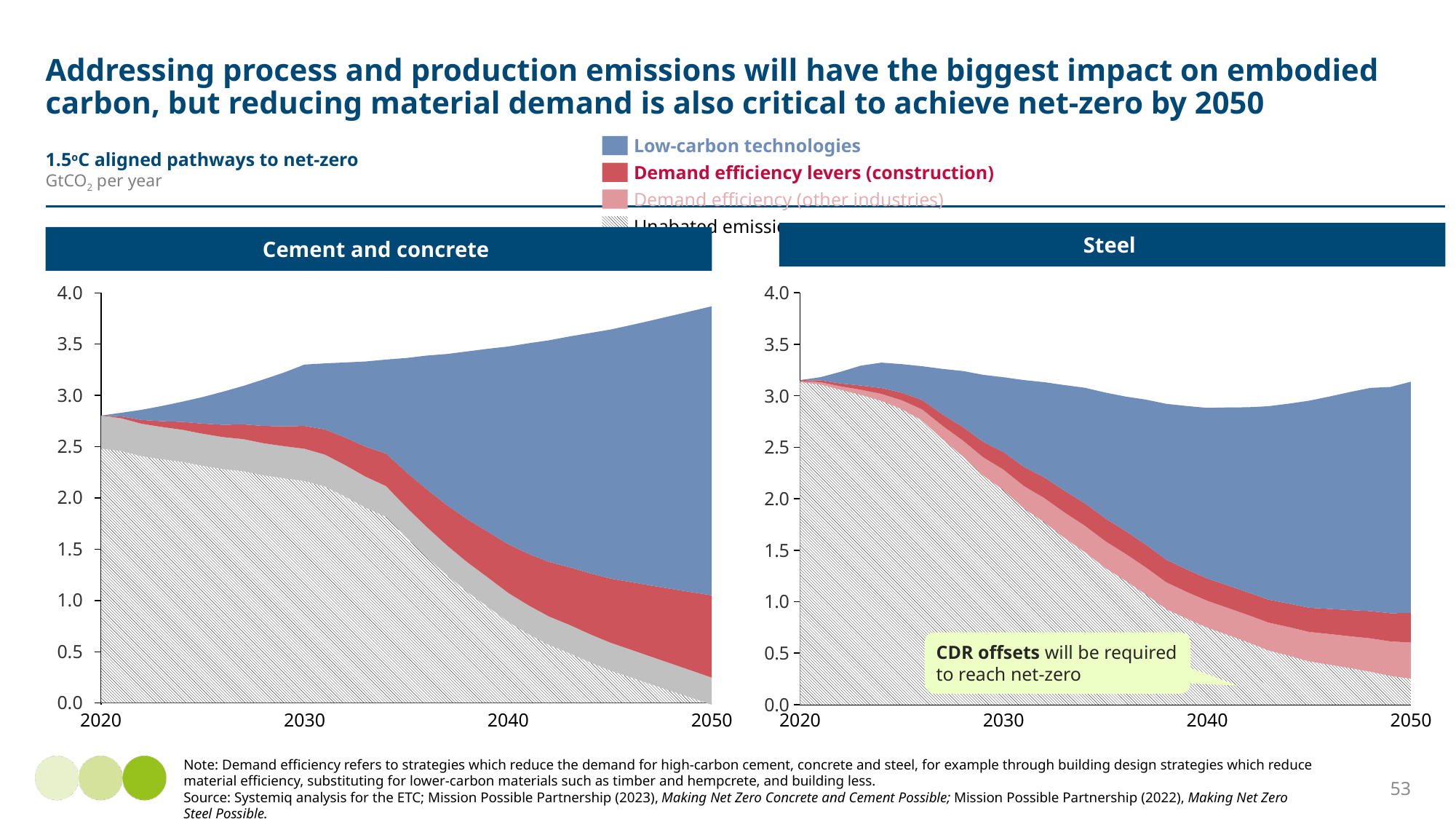
What unit is shown for the y axis of the charts? GtCO2 per year In the Steel chart, is the unabated emissions value in 2050 greater or less than 0.5? less In the Steel chart, is the unabated emissions value in 2040 greater or less than 1.0? less In the Cement and concrete chart, is the unabated emissions value in 2020 greater or less than 2.0? greater How many series does the legend list? 4 In the Cement and concrete chart, does the top of the stacked area rise or fall from 2020 to 2050? rise What kind of chart is the Cement and concrete chart? Stacked area chart In 2050, which chart shows the larger total stacked value, Cement and concrete or Steel? Cement and concrete What does the callout on the Steel chart say will be required to reach net-zero? CDR offsets In the Cement and concrete chart, does the unabated emissions area rise or fall from 2020 to 2050? fall